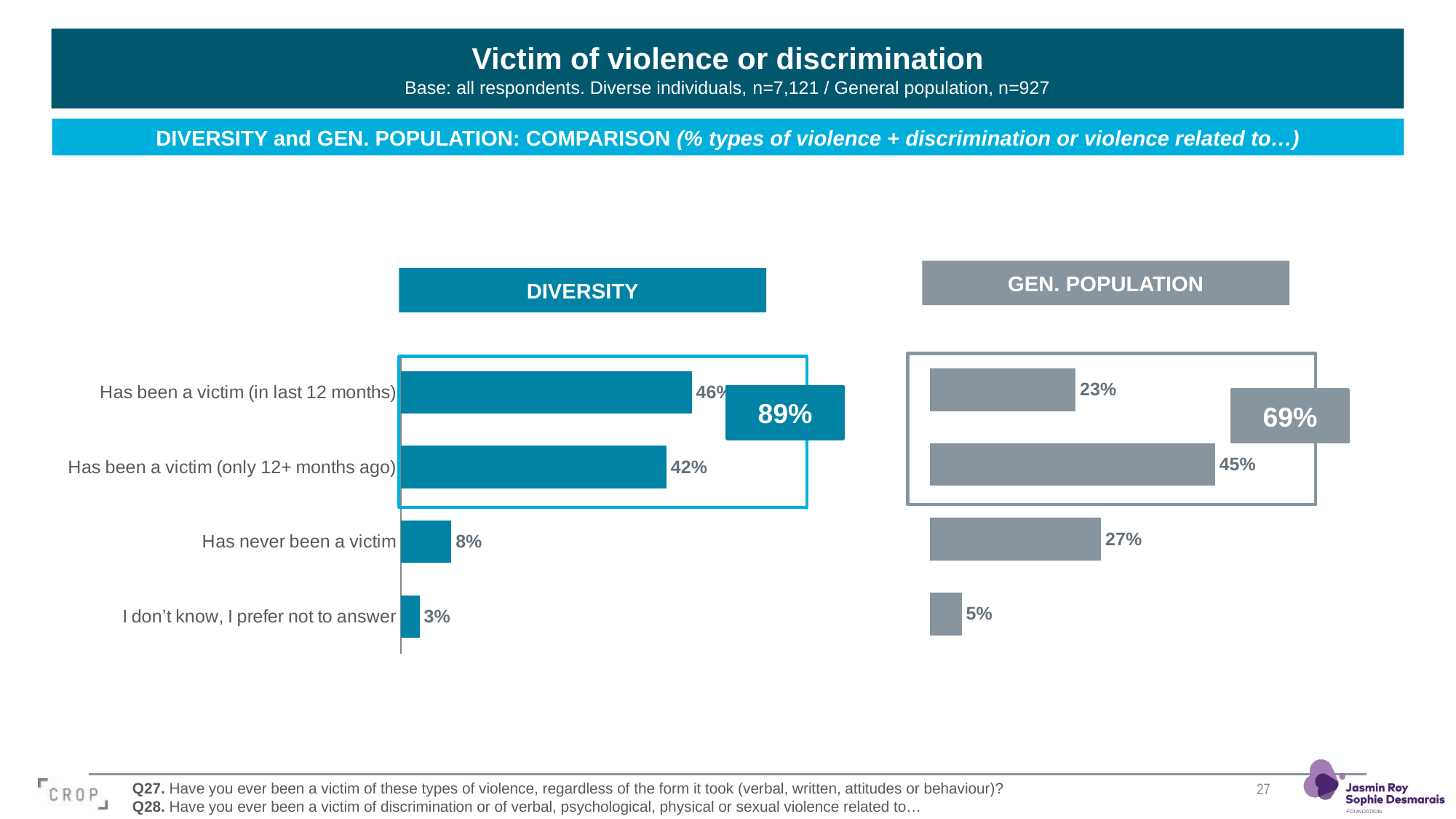
In the DIVERSITY chart, which category has the highest value? Has been a victim (in last 12 months) What is the difference between the DIVERSITY and GEN. POPULATION values for "Has been a victim (in last 12 months)"? 23 percentage points How many categories are shown in the DIVERSITY chart? 4 In the DIVERSITY chart, what is the value for "I don't know, I prefer not to answer"? 3% What type of chart is used for the DIVERSITY data? Bar chart What combined percentage is shown in the highlighted box for the DIVERSITY chart? 89% What combined percentage is shown in the highlighted box for the GEN. POPULATION chart? 69% Which is larger: the "Has never been a victim" value in the DIVERSITY chart or in the GEN. POPULATION chart? GEN. POPULATION In the GEN. POPULATION chart, what is the value for "Has never been a victim"? 27% In the DIVERSITY chart, what is the value for "Has been a victim (in last 12 months)"? 46% In the GEN. POPULATION chart, what is the value for "Has been a victim (only 12+ months ago)"? 45% In the GEN. POPULATION chart, which category has the lowest value? I don't know, I prefer not to answer